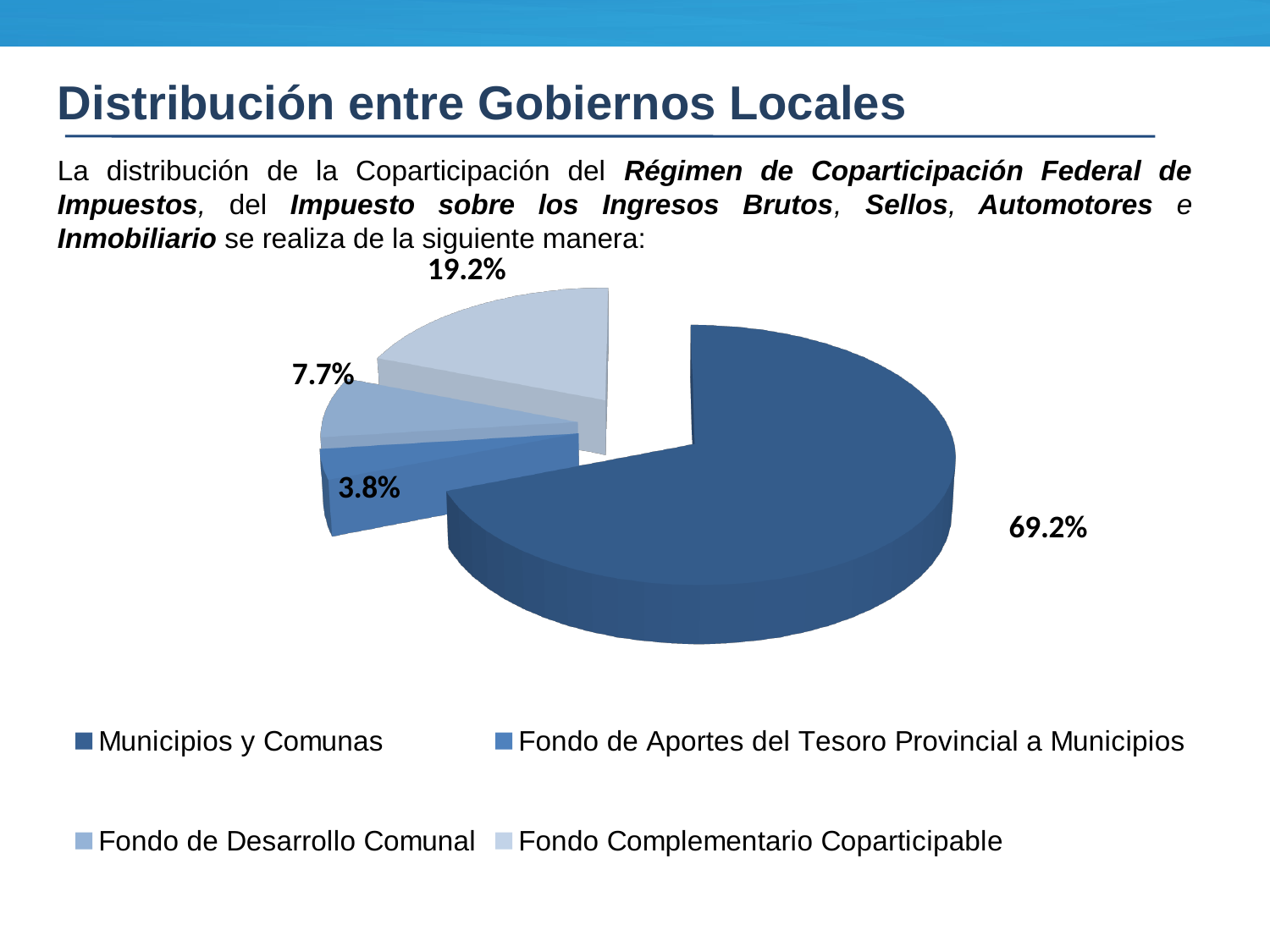
What share of the pie does Fondo de Desarrollo Comunal represent? 7.7% What is the difference between the shares of Municipios y Comunas and Fondo Complementario Coparticipable? 50.0% What is the difference between the shares of Fondo Complementario Coparticipable and Fondo de Desarrollo Comunal? 11.5% What kind of chart is shown on the slide? pie chart What share of the pie does Municipios y Comunas represent? 69.2% How many entries does the legend list? 4 How many slices does the pie chart have? 4 Which is larger, the share of Fondo de Desarrollo Comunal or the share of Fondo de Aportes del Tesoro Provincial a Municipios? Fondo de Desarrollo Comunal What share of the pie does Fondo de Aportes del Tesoro Provincial a Municipios represent? 3.8% Which category has the smallest slice of the pie? Fondo de Aportes del Tesoro Provincial a Municipios Which category has the largest slice of the pie? Municipios y Comunas